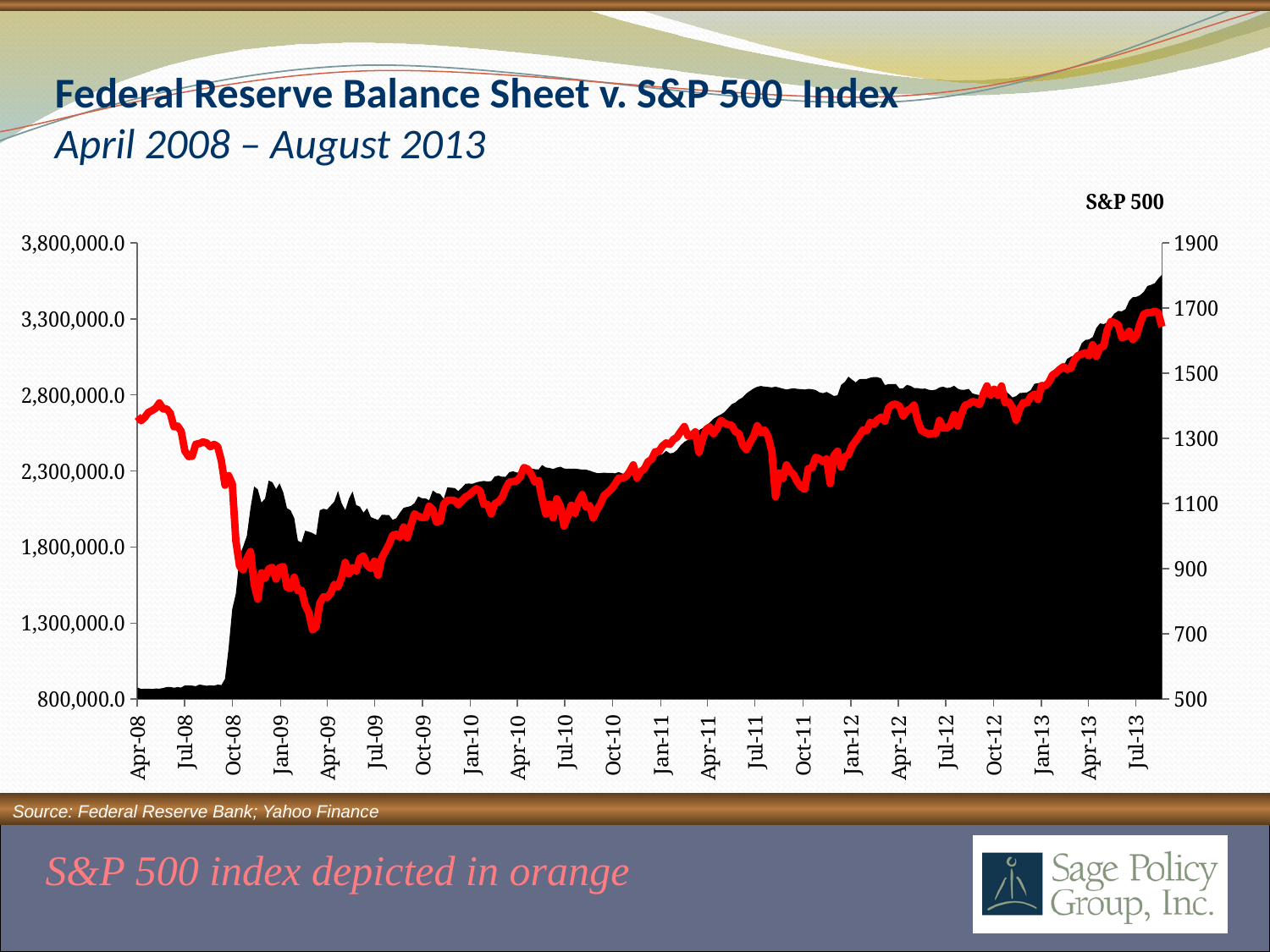
Is the Federal Reserve balance sheet value at Jul-13 greater or less than 3,300,000.0? greater What is the title of the chart on the slide? Federal Reserve Balance Sheet v. S&P 500 Index What label appears above the right-hand axis of the chart? S&P 500 Is the S&P 500 value at Jul-13 greater or less than 1500? greater Which is higher for the S&P 500: the value at Apr-08 or the value at Jul-13? Jul-13 Does the Federal Reserve balance sheet (black area) rise or fall overall from Apr-08 to Jul-13? rise Is the Federal Reserve balance sheet value at Jan-12 greater or less than 2,300,000.0? greater How many date labels are shown along the x axis? 22 What kind of chart is shown on the slide? Area chart with a line